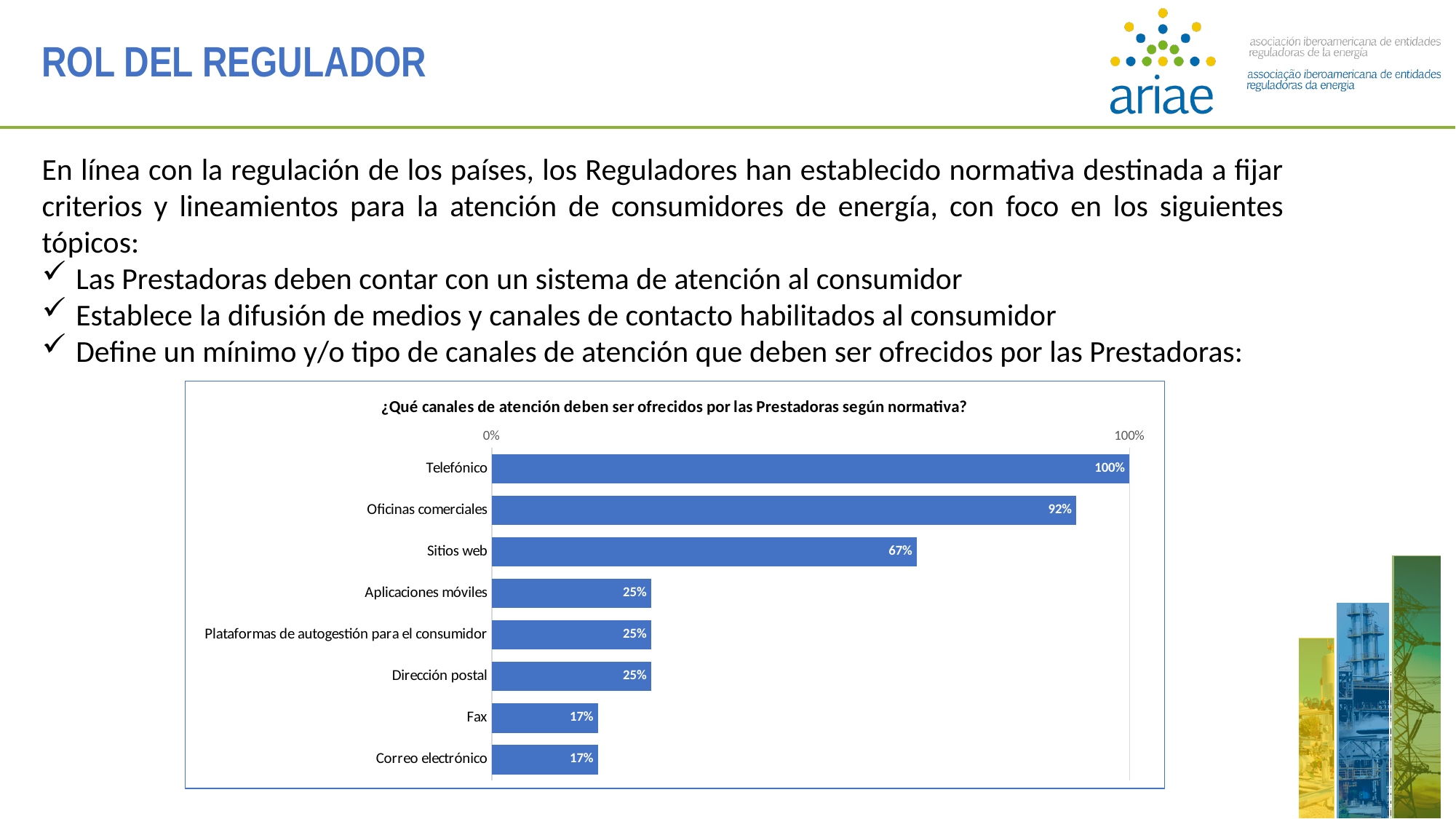
What is the value for Sitios web? 67% What is the value for Telefónico? 100% What is the value for Correo electrónico? 17% What is the value for Oficinas comerciales? 92% Which is larger, the value for Sitios web or the value for Dirección postal? Sitios web What is the value for Aplicaciones móviles? 25% What is the difference between the values for Oficinas comerciales and Sitios web? 25% What is the title of the chart? ¿Qué canales de atención deben ser ofrecidos por las Prestadoras según normativa? Which channel has the highest value? Telefónico How many channels (categories) are shown in the chart? 8 What is the difference between the values for Telefónico and Fax? 83% What kind of chart is shown on the slide? Bar chart